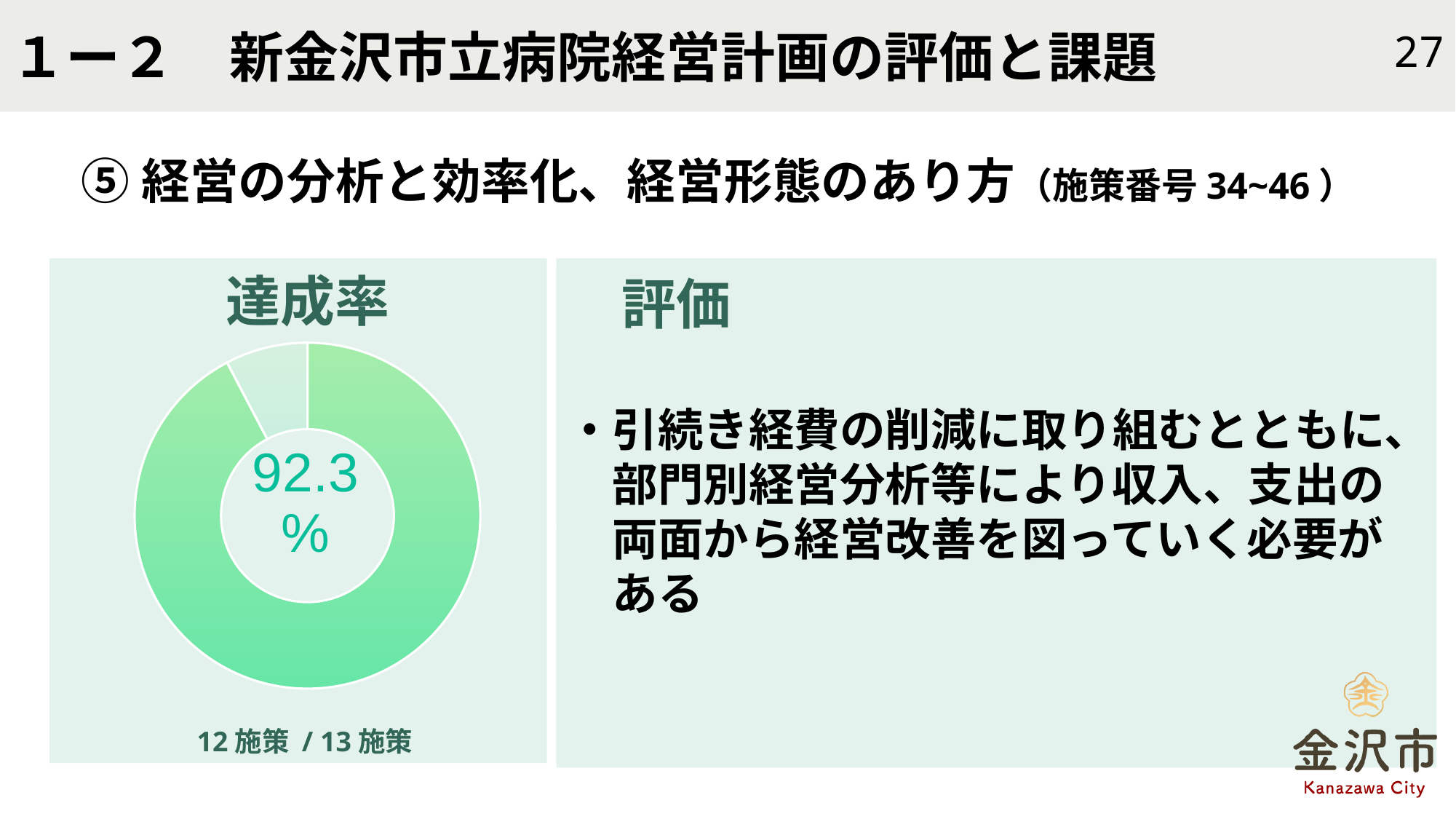
Which policy numbers (施策番号) does the 達成率 chart cover, according to the slide heading? 34~46 What share of the 達成率 donut chart does the large green slice represent? 92.3% Is the achievement rate shown in the 達成率 chart greater or less than 90%? greater Which slice of the 達成率 donut chart is larger, the dark green one or the light green one? The dark green one How many slices does the 達成率 donut chart have? 2 According to the label below the 達成率 chart, what is the total number of measures (施策)? 13 What value is printed in the centre of the 達成率 donut chart? 92.3% Does the 達成率 chart have a legend? No What kind of chart is shown under the heading 達成率? Donut (pie) chart According to the label below the 達成率 chart, how many measures were achieved out of how many? 12 施策 / 13 施策 What is the title of the chart on the left of the slide? 達成率